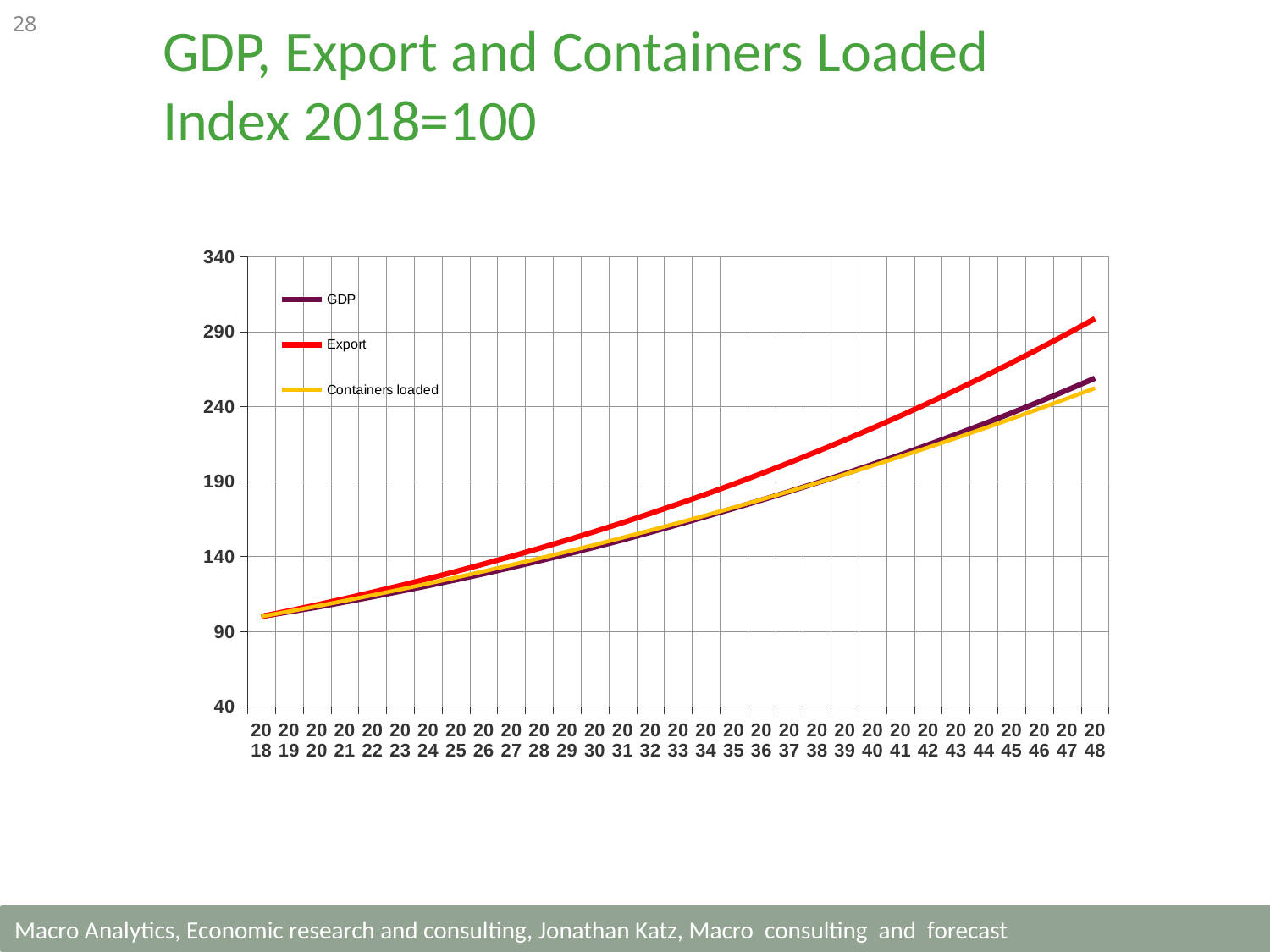
Is the value for Export in 2030 greater or less than 190? less Is the value for Export in 2048 greater or less than 240? greater What kind of chart is shown on the slide? line chart Is the value for GDP in 2048 greater or less than 290? less How many years are plotted along the x axis? 31 What is the index value of the series in the base year 2018? 100 What colour is the Export line in the chart? red Which series has the highest value in 2048? Export Which series has the lowest value in 2048? Containers loaded Do the values of the Export series rise or fall from 2018 to 2048? rise In 2048, which is larger, the value for Export or the value for GDP? Export How many series does the legend list? 3